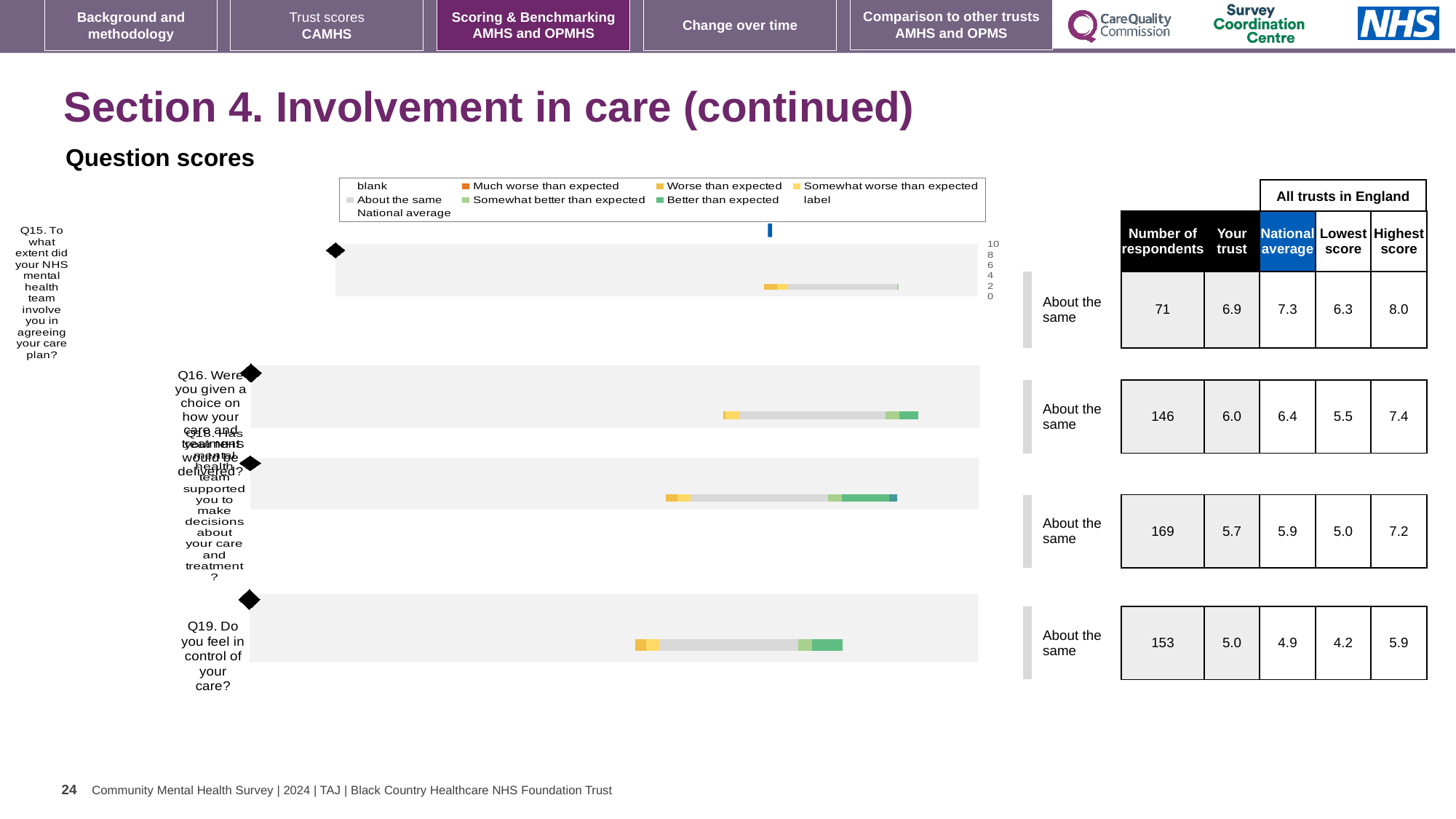
According to the table beside the chart, what is the 'Your trust' score for Q16? 6.0 For Q19, what is the difference between the highest score and the lowest score in the table beside the chart? 1.7 For Q15, which is larger: the 'Your trust' score or the national average? National average According to the table beside the chart, what is the national average for Q18? 5.9 Which question has the smallest number of respondents in the table beside the chart? Q15 What benchmark category is shown for Q15 next to the chart? About the same According to the table beside the chart, what is the highest score among all trusts in England for Q19? 5.9 Which legend entry in the chart is shown in dark green? Better than expected According to the table beside the chart, how many respondents answered Q15? 71 What kind of chart is used to show the question scores on this slide? bar chart Which question has the largest number of respondents in the table beside the chart? Q18 How many questions (categories) are plotted in the question scores chart? 4